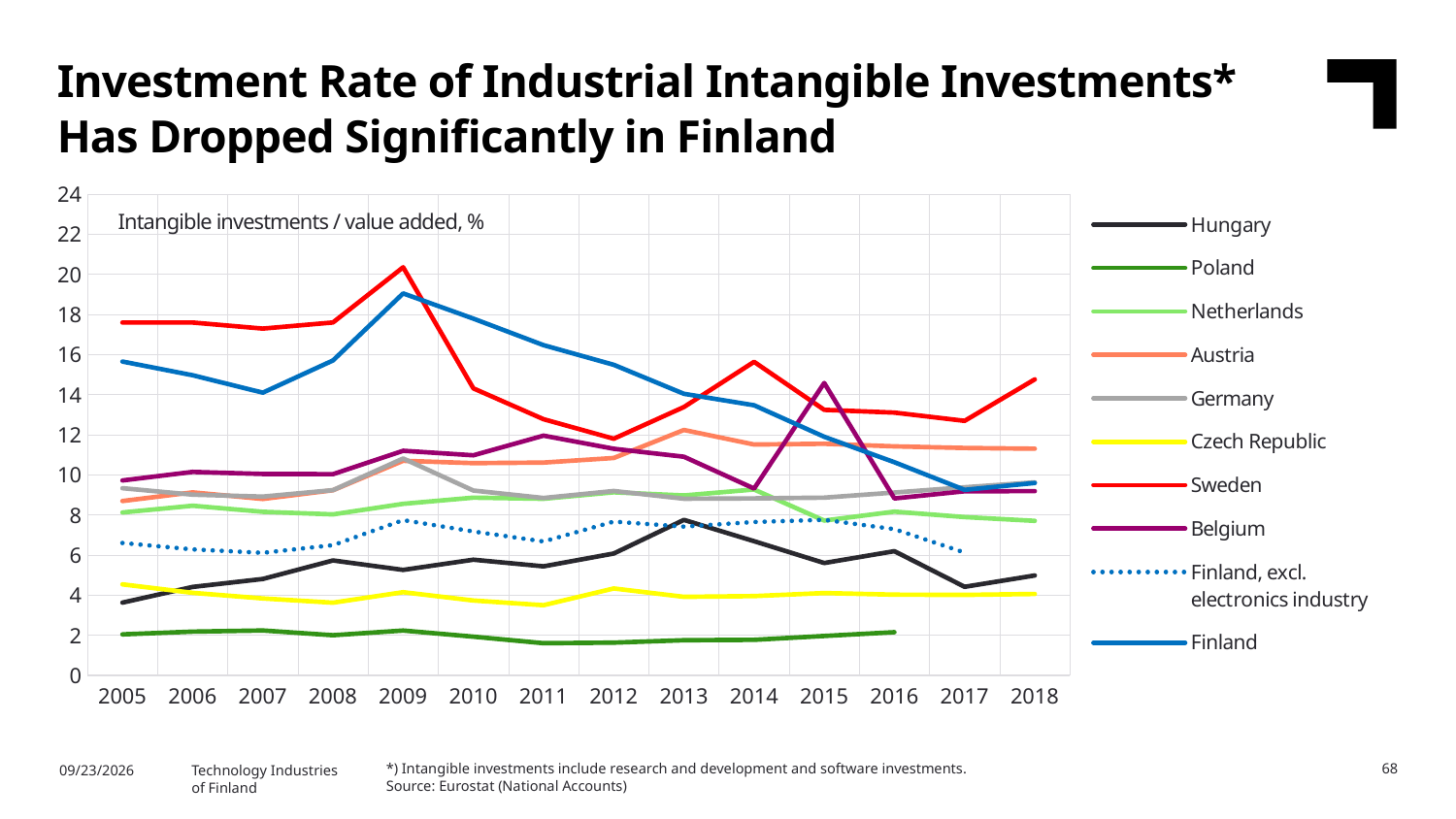
How many series does the legend list? 10 Is the value for Hungary in 2013 greater or less than 6? greater What kind of chart is shown on the slide? line chart Which country has the lowest values across the whole period? Poland Which is larger in 2005, the value for Sweden or the value for Finland? Sweden Is the value for Poland in 2016 greater or less than 4? less Which is larger in 2015, the value for Belgium or the value for Austria? Belgium What label is printed inside the plot area describing the measure? Intangible investments / value added, % Is the value for Finland in 2009 greater or less than 18? greater Does the value for Finland rise or fall from 2009 to 2017? fall Which country has the highest value in 2009? Sweden How many years are shown on the x axis? 14